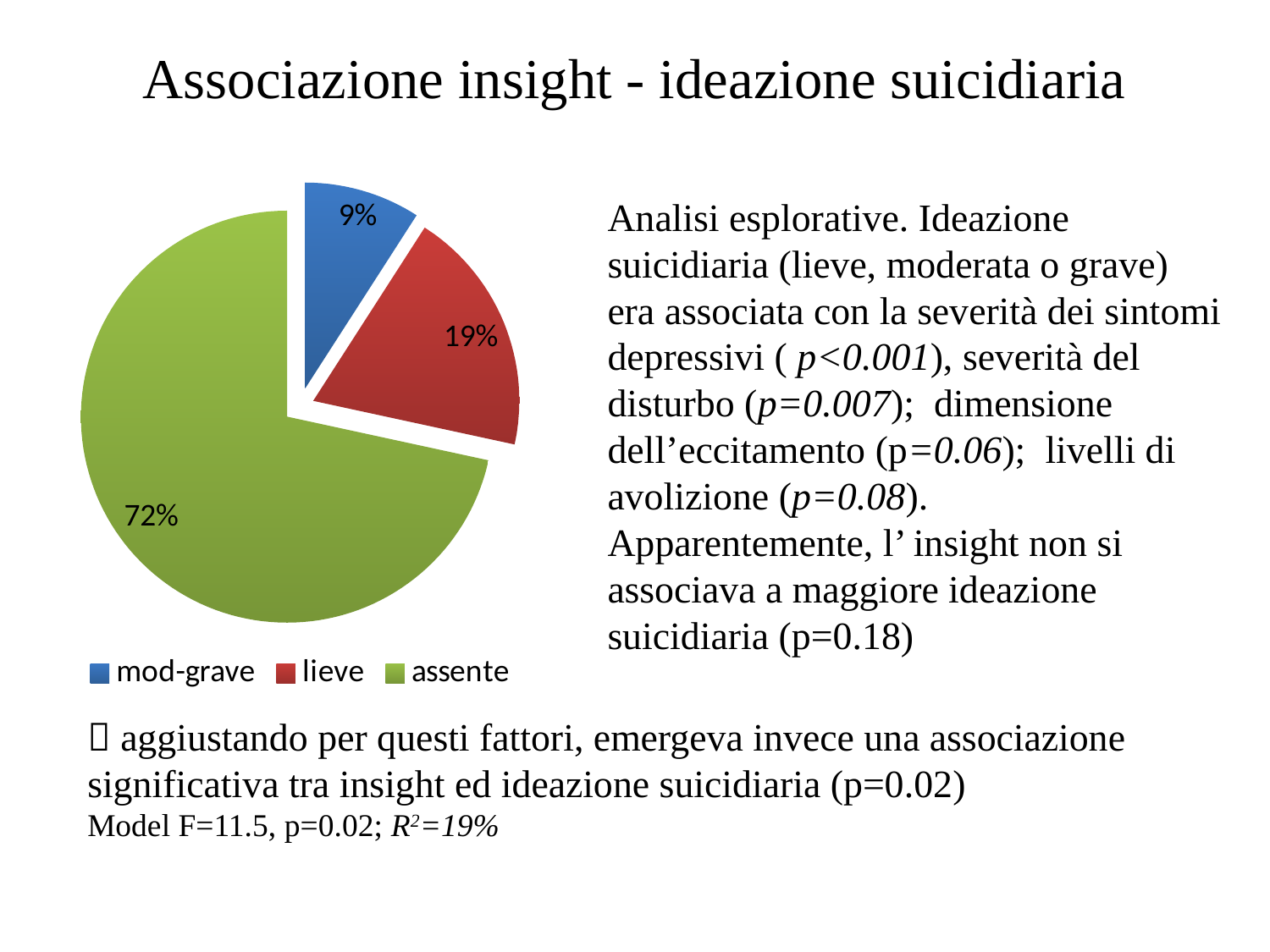
Which category has the smallest slice of the pie? mod-grave Which slice is larger, 'lieve' or 'mod-grave'? lieve What percentage does the 'assente' slice represent? 72% What kind of chart is shown on the slide? pie chart What is the difference in percentage points between the 'assente' and 'lieve' slices? 53 How many categories does the pie chart show? 3 What percentage does the 'mod-grave' slice represent? 9% What is the difference in percentage points between the 'lieve' and 'mod-grave' slices? 10 What colour is the 'assente' slice? green Which category has the largest slice of the pie? assente What percentage does the 'lieve' slice represent? 19% What is the title of the slide containing the pie chart? Associazione insight - ideazione suicidiaria